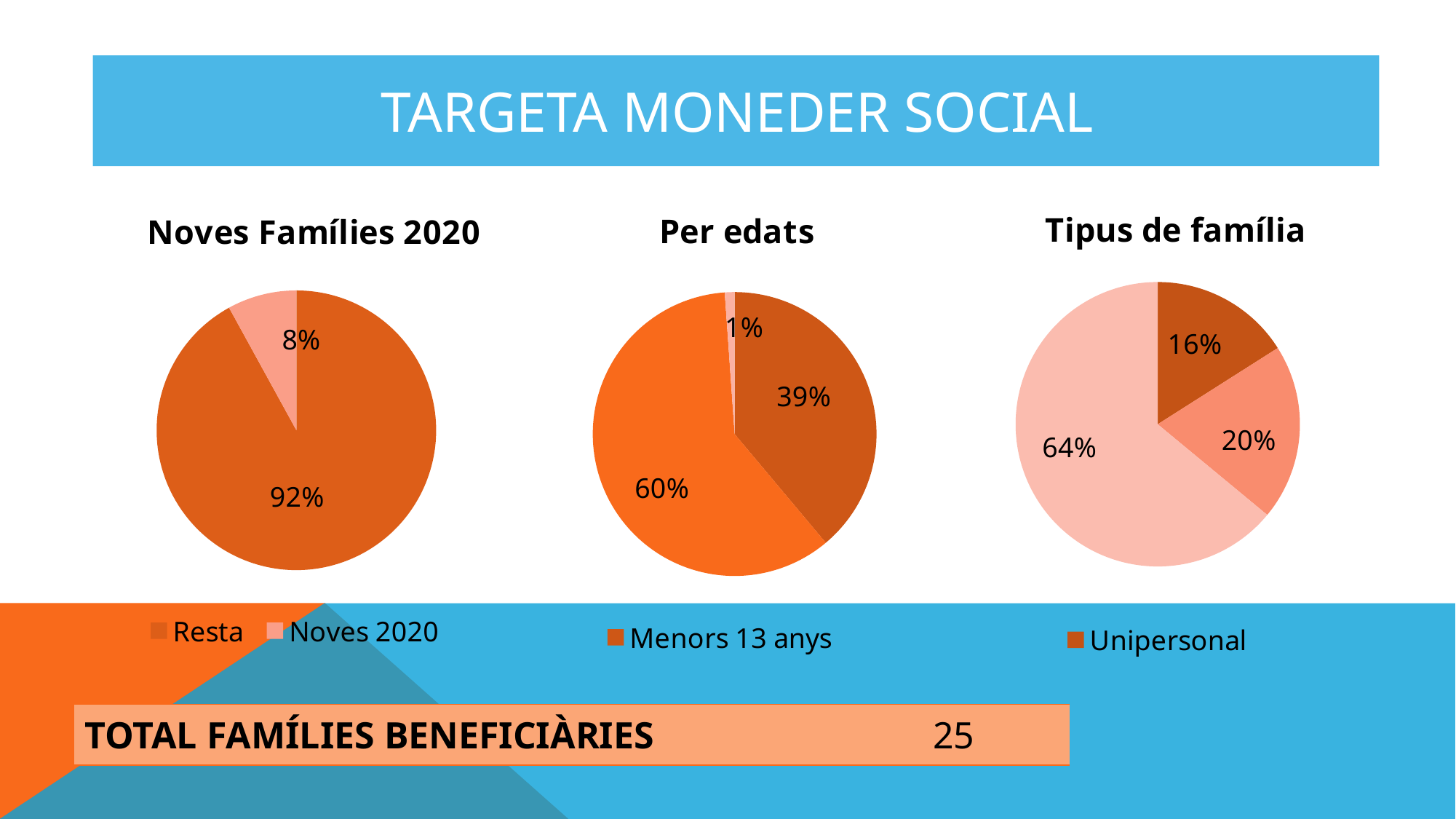
On the 'Per edats' chart, what is the largest percentage shown on any slice? 60% On the 'Noves Famílies 2020' chart, what share is shown for Resta? 92% How many entries does the legend of the 'Noves Famílies 2020' chart list? 2 On the 'Noves Famílies 2020' chart, what is the difference in percentage points between Resta and Noves 2020? 84 On the 'Noves Famílies 2020' chart, which is larger, Resta or Noves 2020? Resta What kind of chart is the 'Tipus de família' chart? Pie chart On the 'Tipus de família' chart, what is the smallest percentage shown on any slice? 16% How many slices does the 'Per edats' chart have? 3 On the 'Per edats' chart, what share is shown for Menors 13 anys? 39% On the 'Tipus de família' chart, what share is shown for Unipersonal? 16% How many slices does the 'Noves Famílies 2020' chart have? 2 On the 'Noves Famílies 2020' chart, what share is shown for Noves 2020? 8%